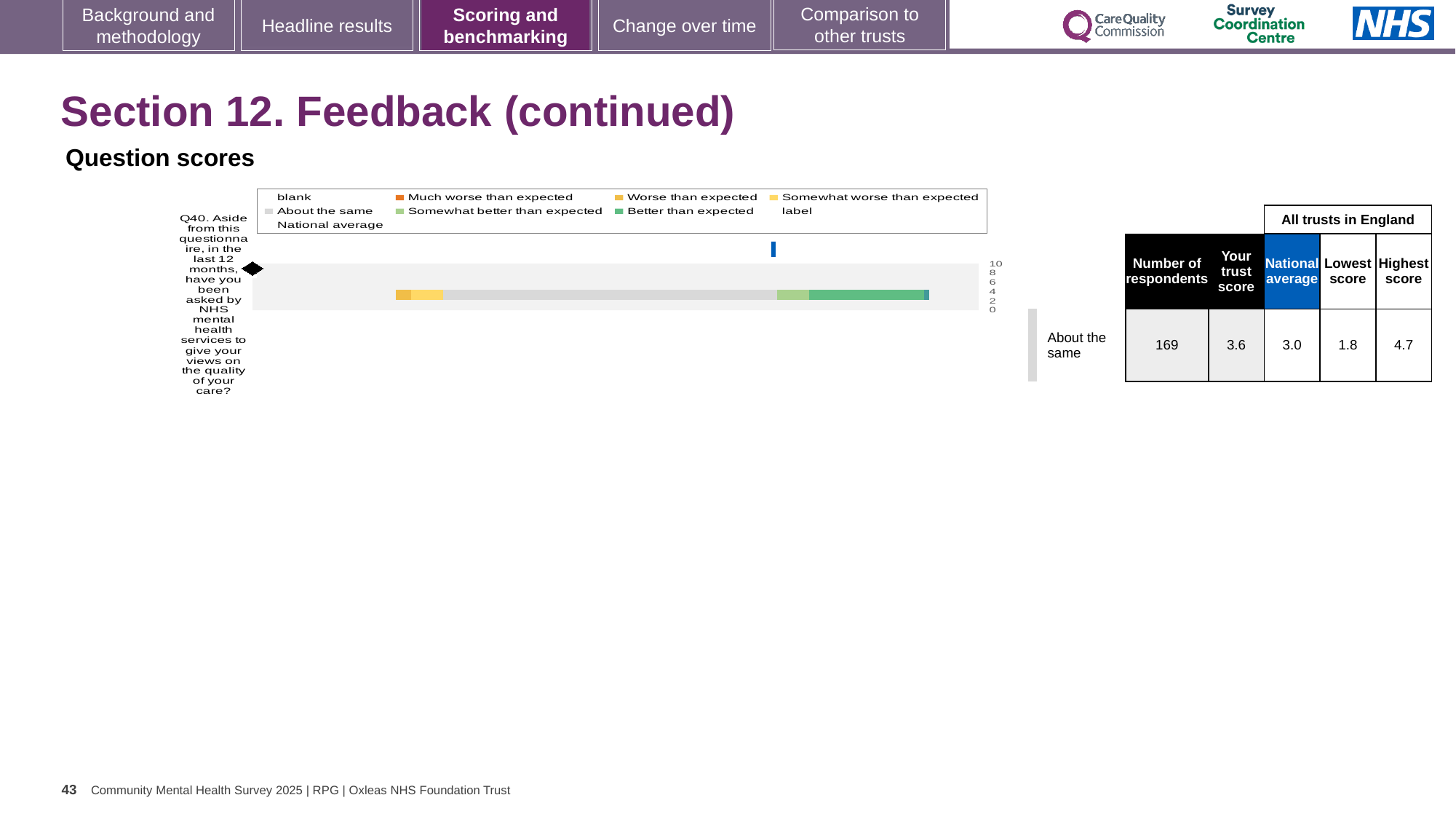
What colour does the legend use for 'Much worse than expected'? orange Which benchmark category is the trust's Q40 score placed in? About the same How many respondents answered Q40? 169 What is the difference between the highest and lowest trust scores for Q40? 2.9 What kind of chart is used to show the Q40 question score? bar chart What is the lowest score among all trusts in England for Q40? 1.8 What is the national average score for Q40? 3.0 Which is larger for Q40, the trust's score or the national average? the trust's score How many survey questions are plotted on the chart? 1 What is the highest score among all trusts in England for Q40? 4.7 What colour does the legend use for 'Better than expected'? green What is the trust's score for Q40? 3.6